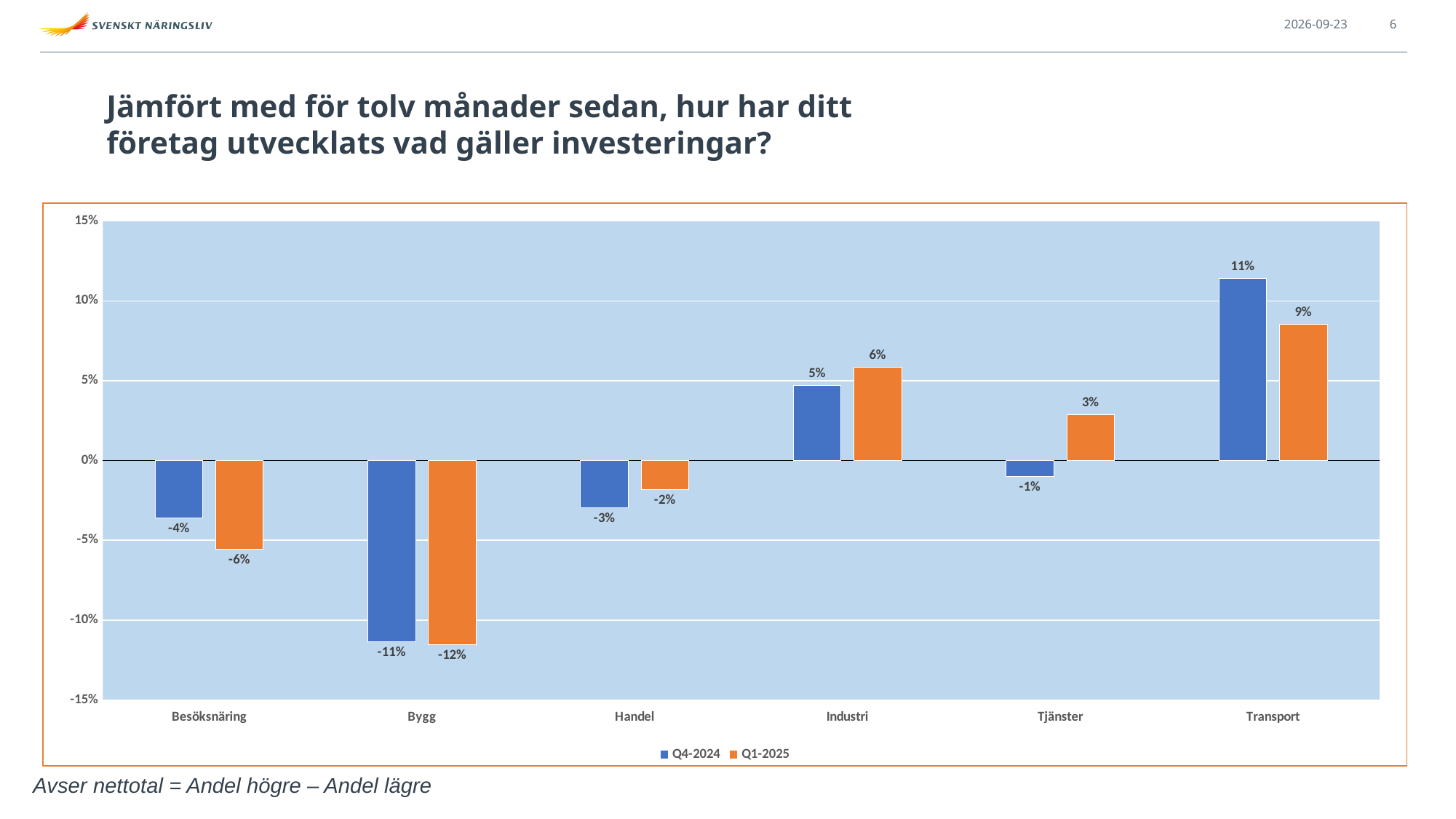
What is the Q1-2025 value for Tjänster? 3% What is the Q4-2024 value for Bygg? -11% What kind of chart is shown on the slide? Bar chart What is the difference between the Q4-2024 and Q1-2025 values for Besöksnäring? 2 percentage points Which category has the lowest Q4-2024 value? Bygg How many series does the legend list? 2 Which is larger for Industri: the Q4-2024 value or the Q1-2025 value? Q1-2025 Which category has the highest Q1-2025 value? Transport Which colour represents the Q1-2025 series? Orange How many categories are shown on the x axis? 6 What is the Q4-2024 value for Handel? -3% What is the Q1-2025 value for Transport? 9%